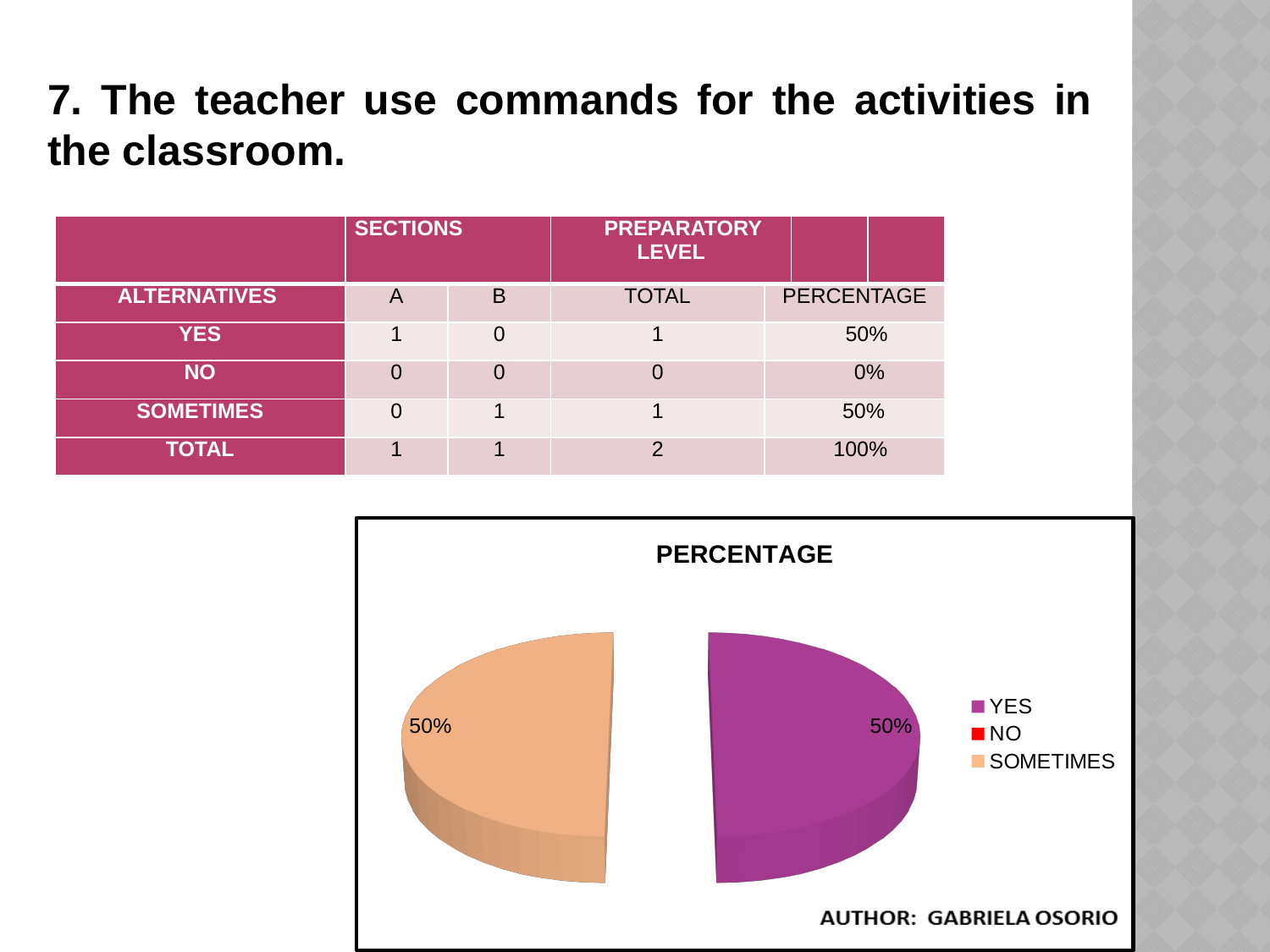
What share of the pie does the SOMETIMES slice represent? 50% Which legend entry has no visible slice in the pie chart? NO What is the difference between the YES share and the SOMETIMES share? 0% How many slices are visibly drawn in the pie chart? 2 What kind of chart is shown on the slide? pie chart What is the title of the chart? PERCENTAGE What is the combined share of the YES and SOMETIMES slices? 100% How many entries does the chart's legend list? 3 Is the share for YES larger than, smaller than, or equal to the share for SOMETIMES? equal What share of the pie does the YES slice represent? 50%